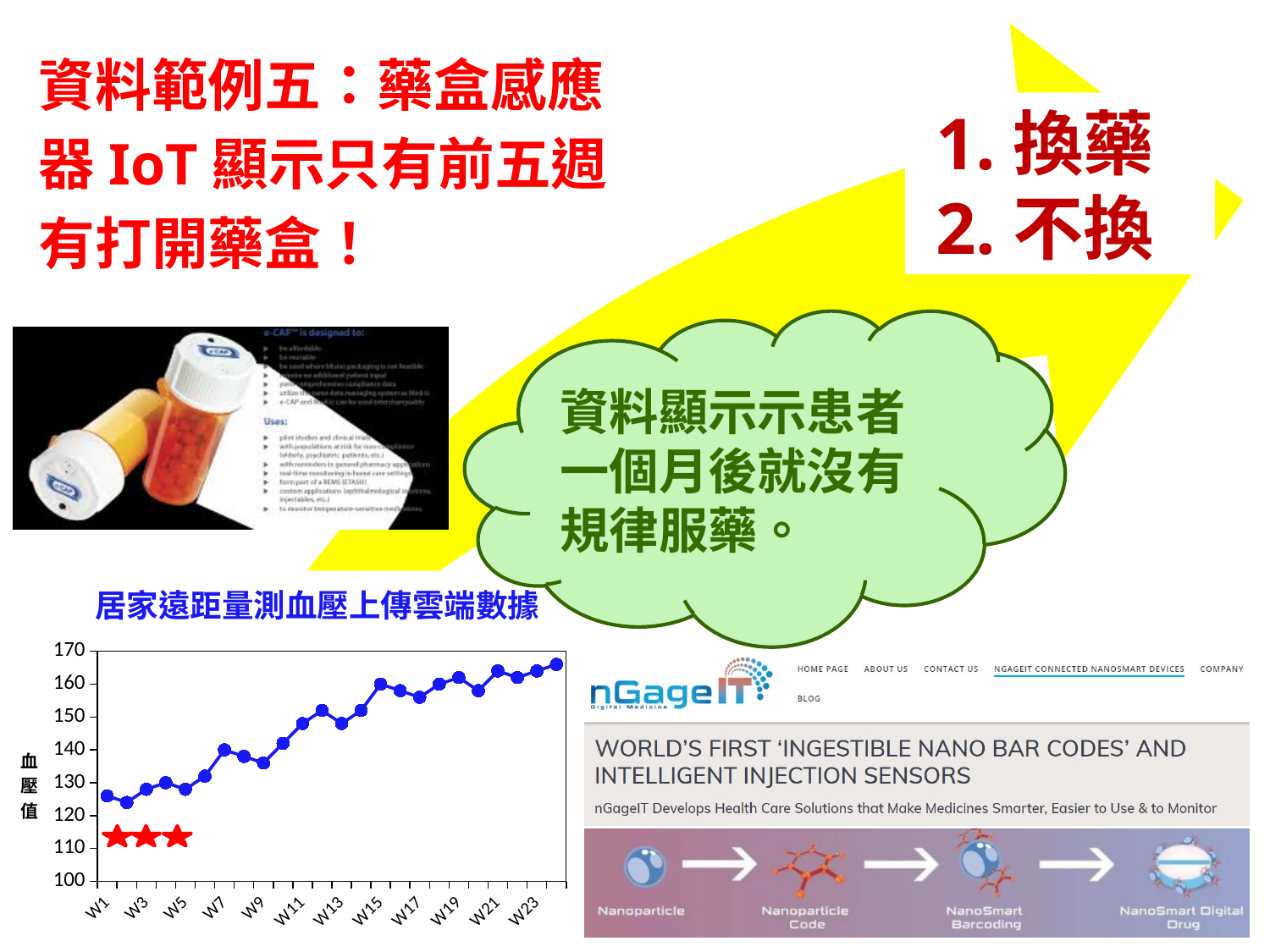
What is the title of the chart at the bottom left of the slide? 居家遠距量測血壓上傳雲端數據 Is the blood pressure value for W7 greater or less than 130? greater Is the blood pressure value for W15 greater or less than 150? greater Is the blood pressure value for W1 greater or less than 130? less How many weekly data points are plotted on the blood pressure chart? 24 What is the label on the vertical axis of the blood pressure chart? 血壓值 Which week has the higher blood pressure value, W1 or W24? W24 What kind of chart is shown at the bottom left of the slide? line chart Do the blood pressure values generally rise or fall from W1 to W24? rise Which week has the higher blood pressure value, W3 or W7? W7